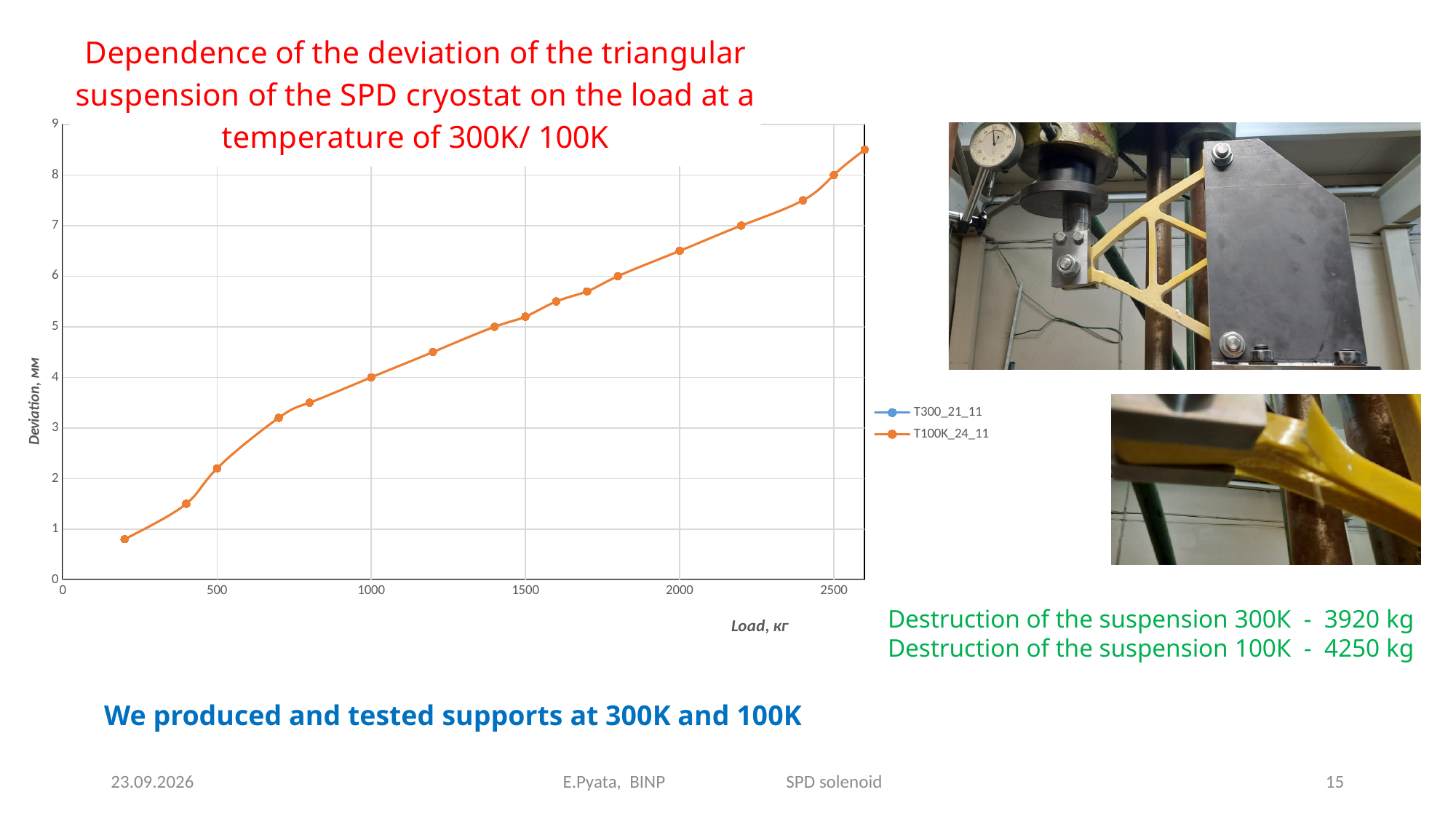
Is the deviation of the T100K_24_11 series at a load of 500 kg greater or less than 2? greater Which is larger for the T100K_24_11 series: the deviation at 1000 kg or the deviation at 2000 kg? 2000 kg What is the label of the vertical axis of the chart? Deviation, мм How many series does the chart legend list? 2 At which load does the T100K_24_11 series reach its lowest deviation? 200 kg What is the deviation of the T100K_24_11 series at a load of 2500 kg? 8 Is the deviation of the T100K_24_11 series at a load of 1500 kg greater or less than 5? greater What kind of chart is shown on the slide? line chart Is the deviation of the T100K_24_11 series at a load of 2000 kg greater or less than 7? less What is the deviation of the T100K_24_11 series at a load of 1000 kg? 4 Does the deviation rise or fall as the load increases along the x axis? rises What are the two series names listed in the chart legend? T300_21_11 and T100K_24_11